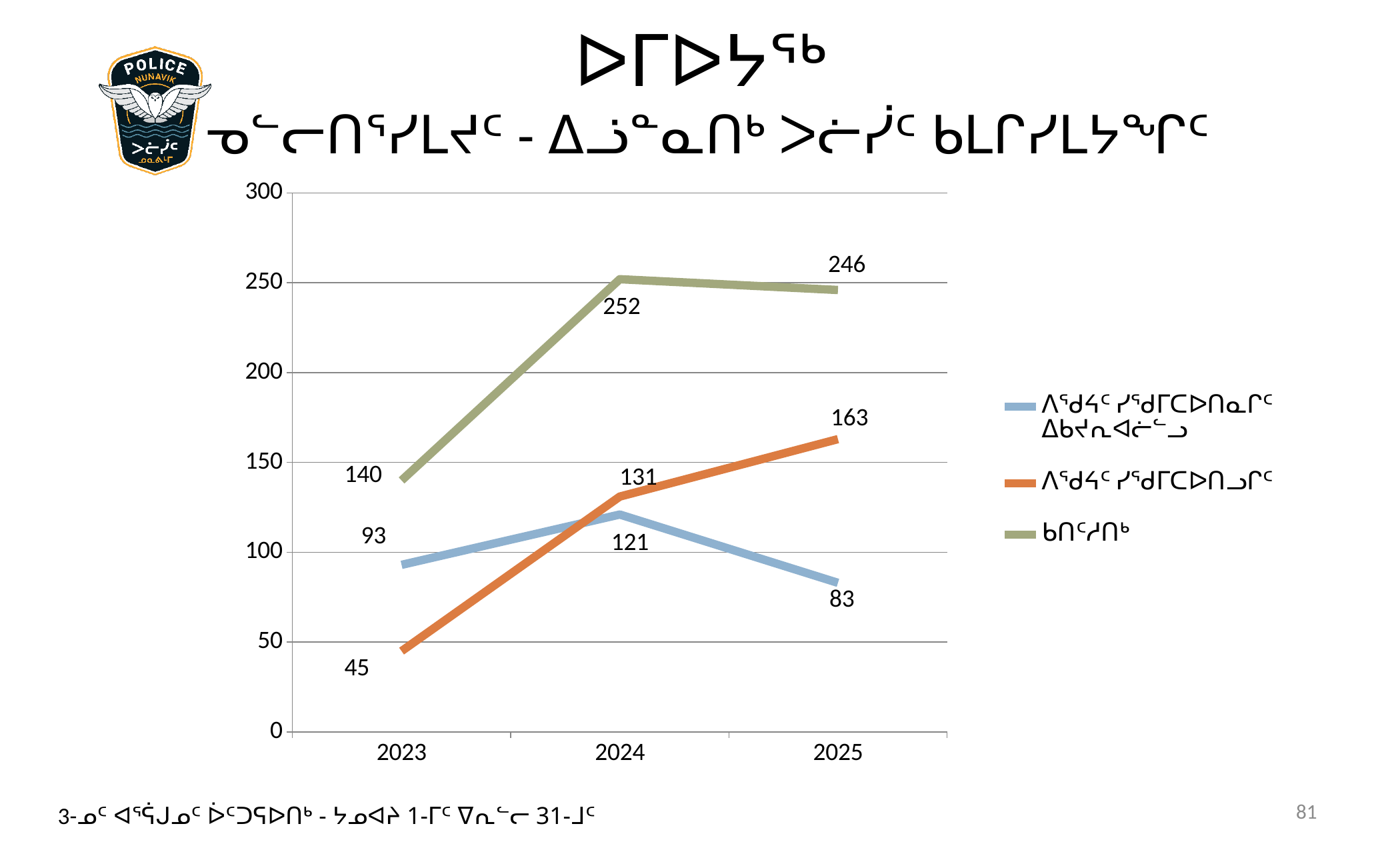
In which year is the orange line at its lowest value? 2023 Is the value of the green line in 2025 greater or less than 200? greater In which year does the green line reach its highest value? 2024 By how much does the orange line increase from 2023 to 2025? 118 How many years are shown on the x axis? 3 What is the value of the orange line in 2025? 163 In 2024, which line has the larger value, the blue line or the orange line? the orange line What kind of chart is shown on the slide? line chart What is the value of the blue line in 2024? 121 What is the value of the green line in 2023? 140 How many series does the legend list? 3 By how much does the green line drop from 2024 to 2025? 6